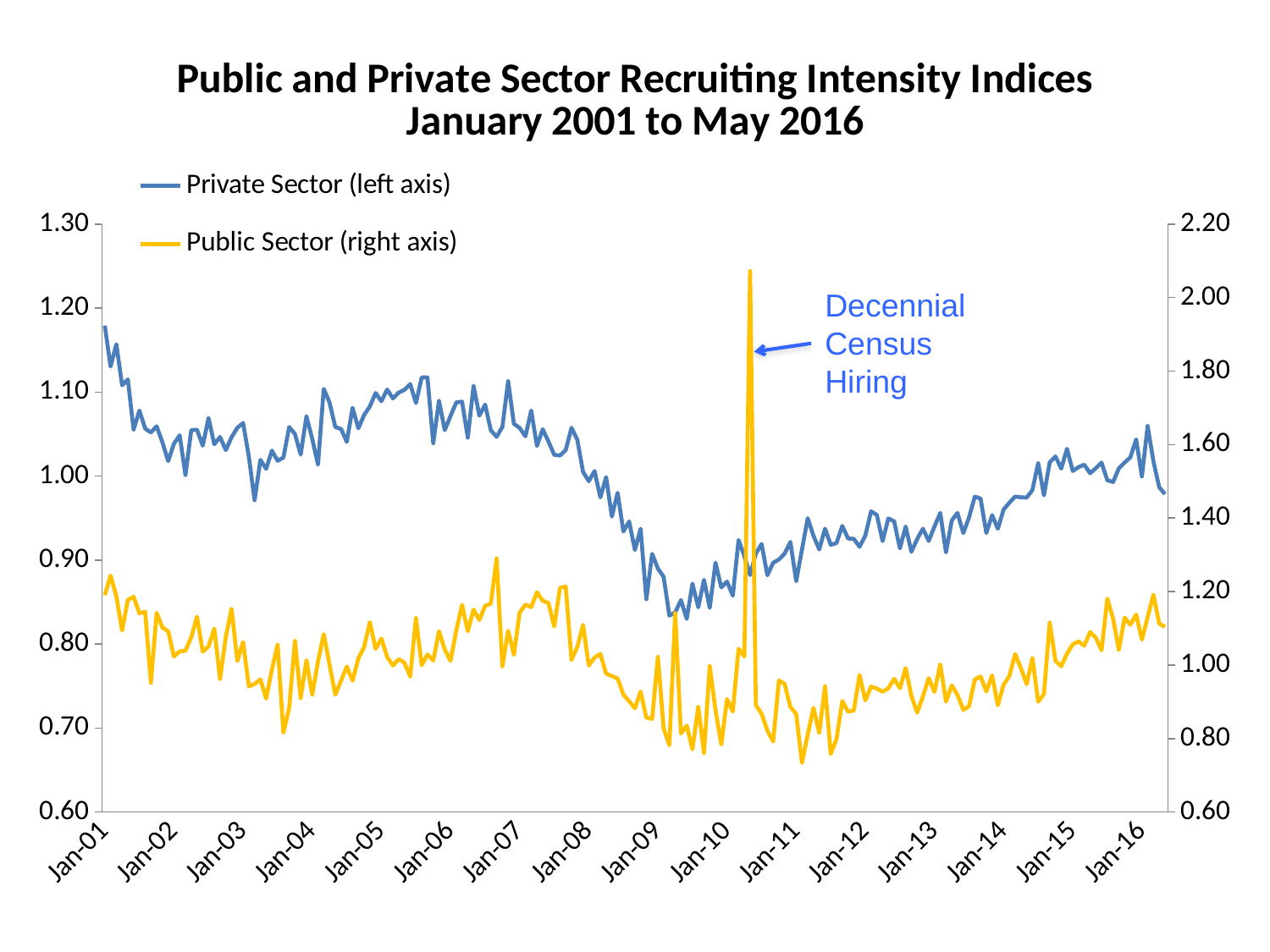
How many series does the legend list? 2 Is the lowest value of the Private Sector series greater or less than 0.90? less What is the title of the chart? Public and Private Sector Recruiting Intensity Indices January 2001 to May 2016 What kind of chart is shown on the slide? line chart Does the Private Sector series generally rise or fall between Jan-10 and Jan-16? rise How many year labels appear on the x axis? 16 Is the Public Sector value at Jan-01 (right axis) greater or less than 1.00? greater Is the peak value of the Public Sector series (right axis) greater or less than 2.00? greater Does the Private Sector series rise or fall between Jan-08 and Jan-09? fall What does the annotation next to the spike in the Public Sector series say? Decennial Census Hiring